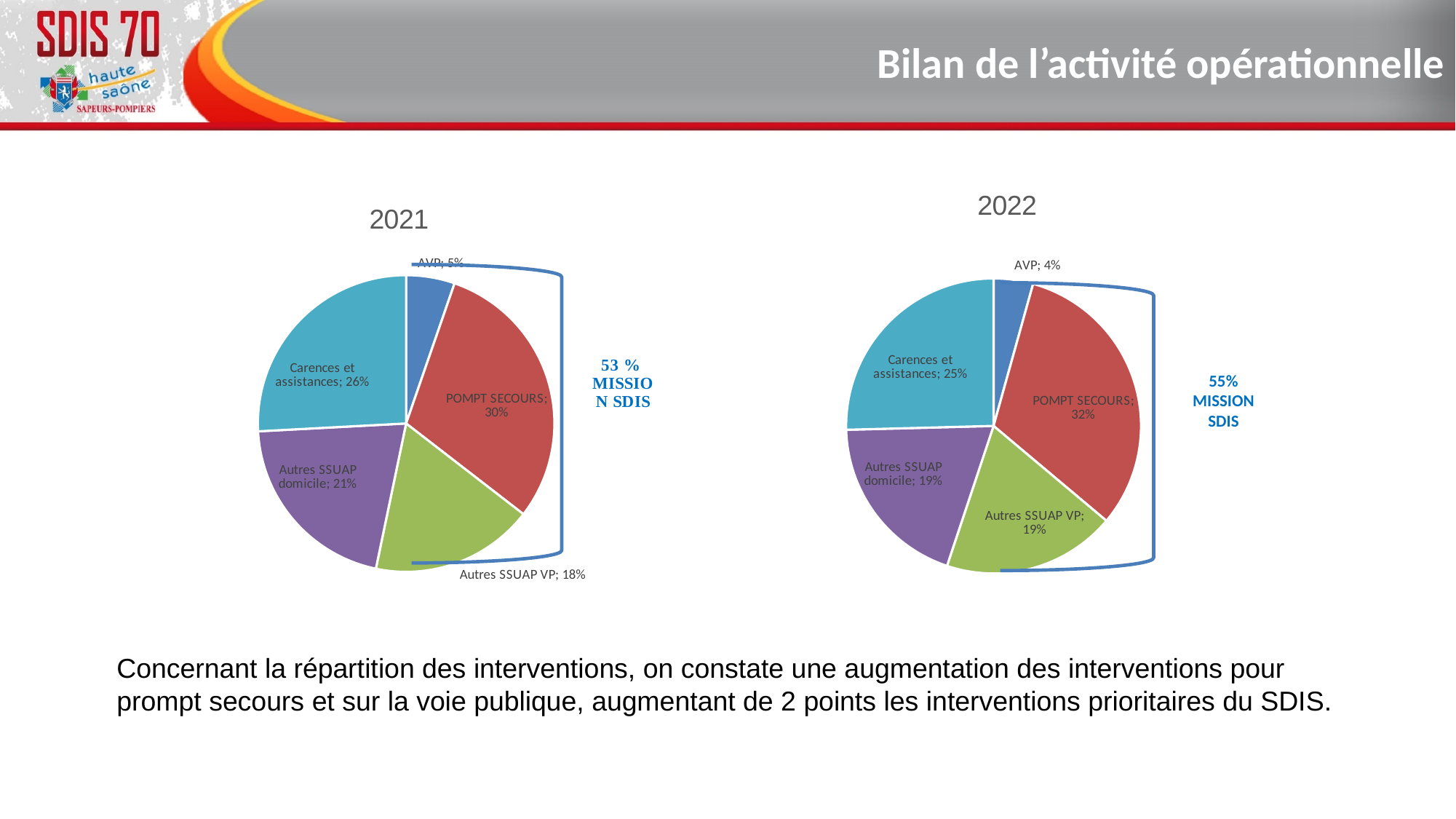
In the 2021 pie chart, what share is labelled for POMPT SECOURS? 30% What percentage is annotated as MISSION SDIS next to the 2022 pie chart? 55% In the 2021 pie chart, what share is labelled for Autres SSUAP domicile? 21% In the 2021 pie chart, what share is labelled for Autres SSUAP VP? 18% How many slices does the 2022 pie chart have? 5 In the 2022 pie chart, which category has the largest slice? POMPT SECOURS In the 2022 pie chart, what share is labelled for AVP? 4% In the 2021 pie chart, which is larger: Carences et assistances or Autres SSUAP domicile? Carences et assistances In the 2021 pie chart, which category has the smallest slice? AVP What type of chart is used for the 2021 data? Pie chart In the 2022 pie chart, what share is labelled for Carences et assistances? 25% What is the difference in percentage points between POMPT SECOURS in 2022 and POMPT SECOURS in 2021? 2 points